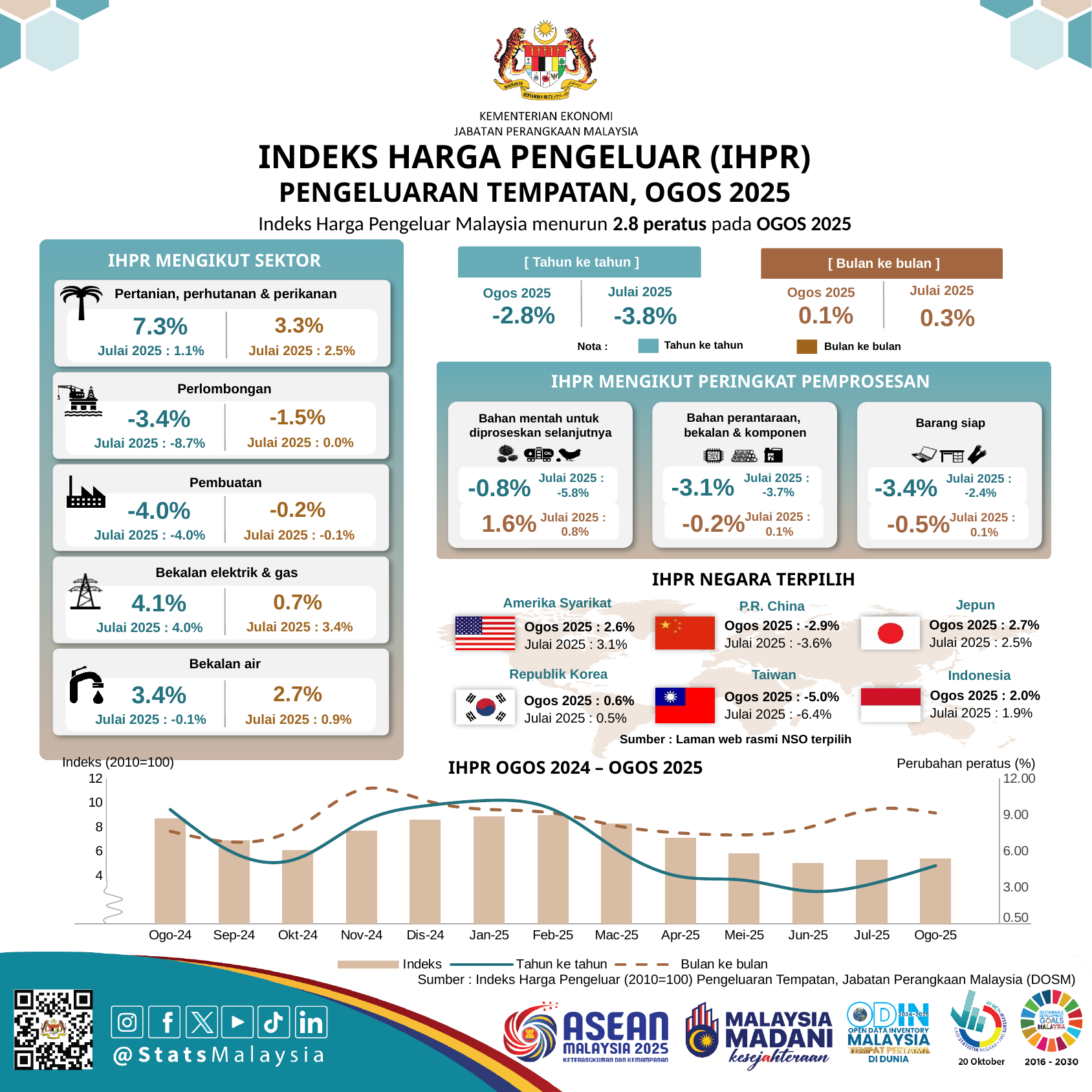
In the 'IHPR OGOS 2024 – OGOS 2025' chart, do the Indeks bars rise or fall from Mac-25 to Jun-25? fall In the 'IHPR OGOS 2024 – OGOS 2025' chart, is the Indeks bar for Nov-24 greater or less than 6? greater What are the three legend entries of the 'IHPR OGOS 2024 – OGOS 2025' chart? Indeks, Tahun ke tahun, Bulan ke bulan How many series does the legend of the 'IHPR OGOS 2024 – OGOS 2025' chart list? 3 How many months are shown on the x axis of the 'IHPR OGOS 2024 – OGOS 2025' chart? 13 In the 'IHPR OGOS 2024 – OGOS 2025' chart, which Indeks bar is taller, Jan-25 or Jun-25? Jan-25 In the 'IHPR OGOS 2024 – OGOS 2025' chart, is the Indeks bar for Jun-25 greater or less than 6? less What kind of chart is the 'IHPR OGOS 2024 – OGOS 2025' chart? A combined bar and line chart In the 'IHPR OGOS 2024 – OGOS 2025' chart, is the Indeks bar for Ogo-24 greater or less than 8? greater In the 'IHPR OGOS 2024 – OGOS 2025' chart, which Indeks bar is taller, Ogo-24 or Ogo-25? Ogo-24 What is the label of the right-hand axis of the 'IHPR OGOS 2024 – OGOS 2025' chart? Perubahan peratus (%)